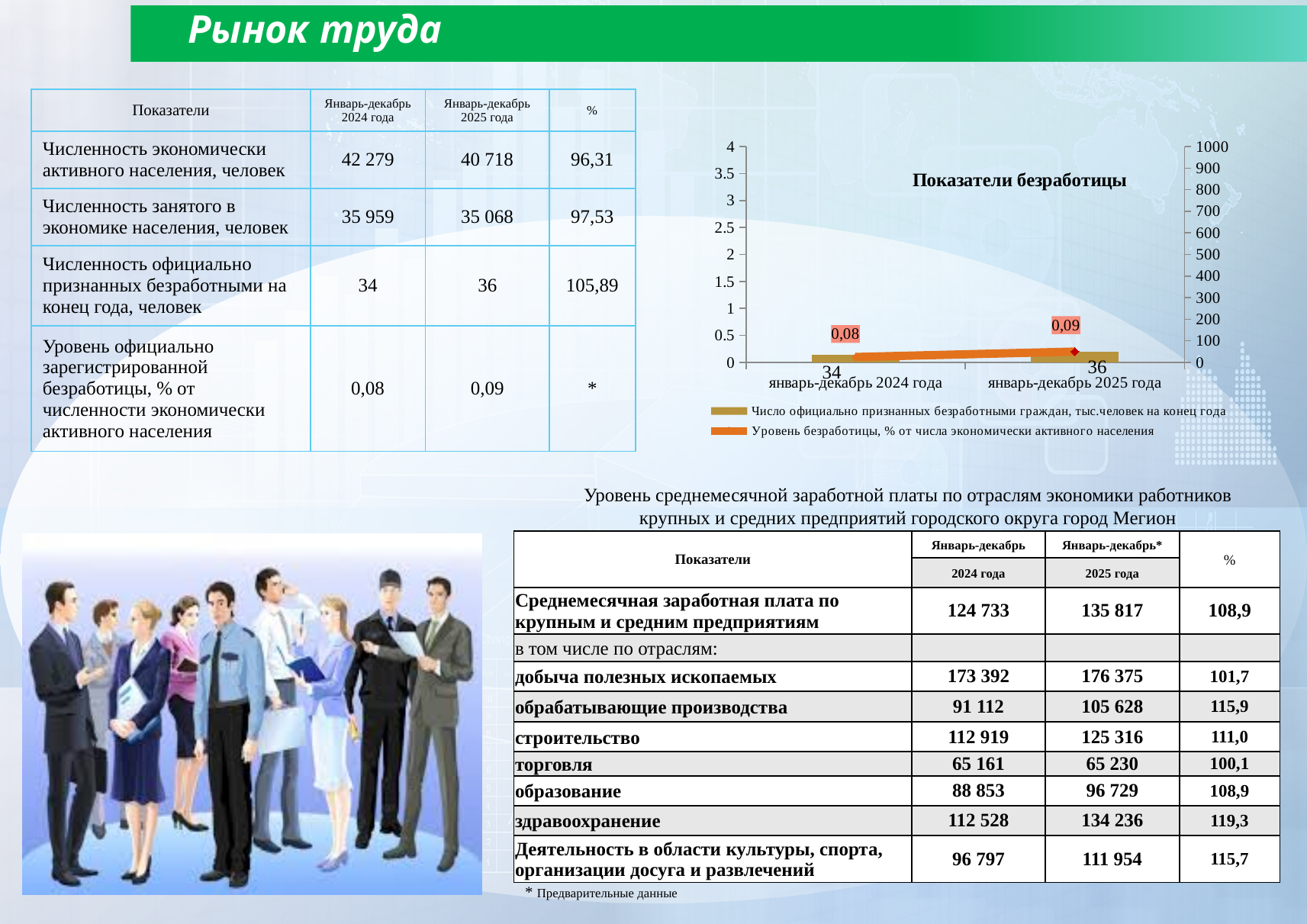
In the chart 'Показатели безработицы', does the number of officially recognised unemployed citizens rise or fall from 2024 to 2025? rise In the chart 'Показатели безработицы', what is the 'Уровень безработицы' value for январь-декабрь 2025 года? 0,09 How many periods (categories) are shown on the x axis of the chart 'Показатели безработицы'? 2 In the chart 'Показатели безработицы', what is the value of 'Число официально признанных безработными граждан' for январь-декабрь 2024 года? 34 In the chart 'Показатели безработицы', what is the 'Уровень безработицы' value for январь-декабрь 2024 года? 0,08 How many series does the legend of the chart 'Показатели безработицы' list? 2 In the chart 'Показатели безработицы', is the unemployment rate for январь-декабрь 2025 года higher or lower than for январь-декабрь 2024 года? higher In the chart 'Показатели безработицы', what is the value of 'Число официально признанных безработными граждан' for январь-декабрь 2025 года? 36 In the chart 'Показатели безработицы', by how much did the number of officially recognised unemployed citizens change from январь-декабрь 2024 года to январь-декабрь 2025 года? 2 In the chart 'Показатели безработицы', which period has the lower unemployment rate? январь-декабрь 2024 года In the chart 'Показатели безработицы', which period has the higher number of officially recognised unemployed citizens? январь-декабрь 2025 года What is the title of the chart on the slide? Показатели безработицы